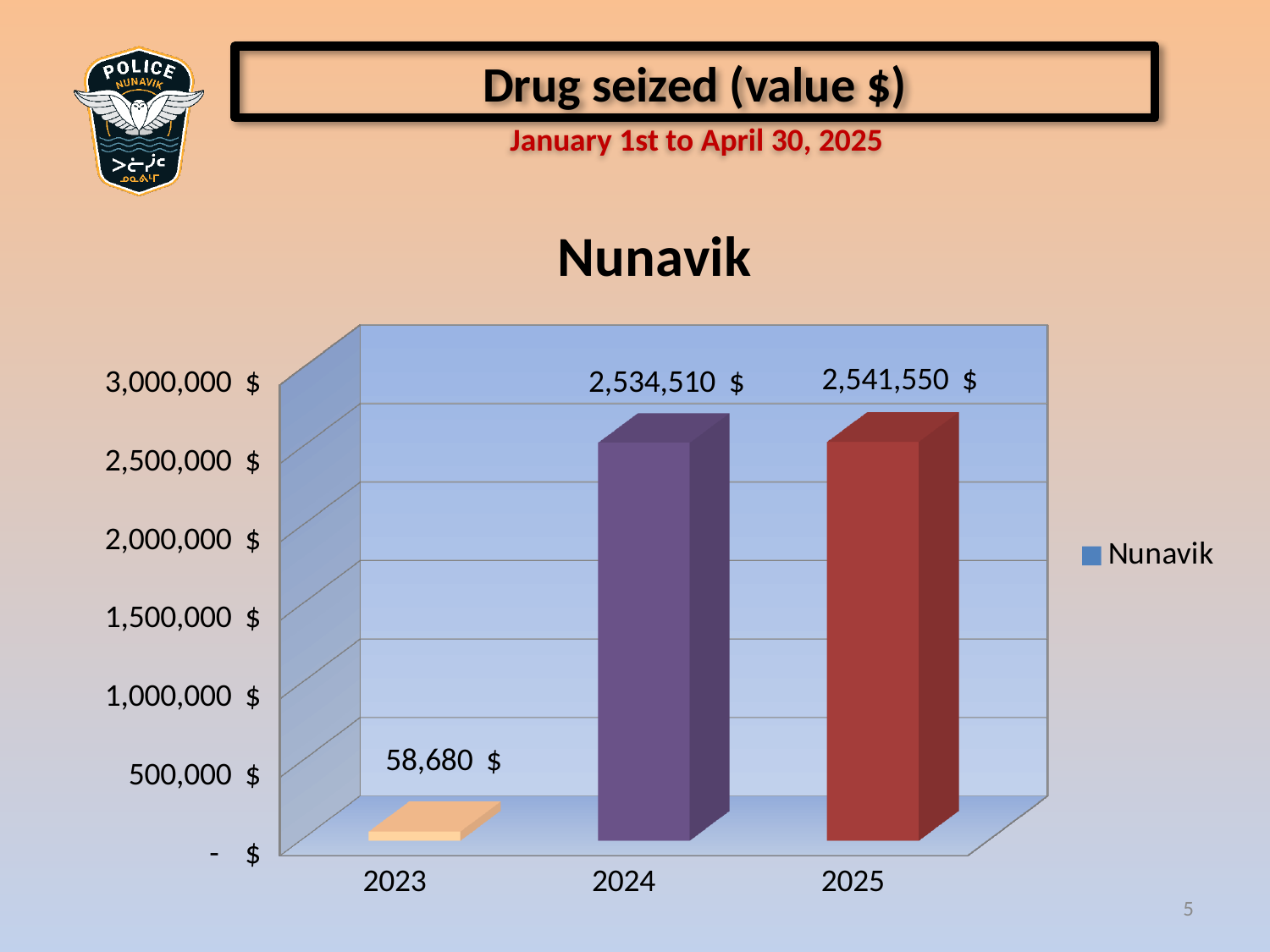
Which year has the highest value of drugs seized, according to the data labels? 2025 What is the difference between the 2024 and 2023 values? 2,475,830 $ What is the value for 2024 in the Nunavik chart? 2,534,510 $ What is the difference between the 2025 and 2024 values? 7,040 $ What kind of chart is shown on the slide? Bar chart Is the value for 2023 greater or less than 500,000 $? less What is the value for 2023 in the Nunavik chart? 58,680 $ What is the value for 2025 in the Nunavik chart? 2,541,550 $ Which year has the lowest value of drugs seized? 2023 How many years are shown on the x axis of the chart? 3 Is the value for 2024 greater or less than 2,000,000 $? greater Which is larger, the value for 2023 or the value for 2024? 2024